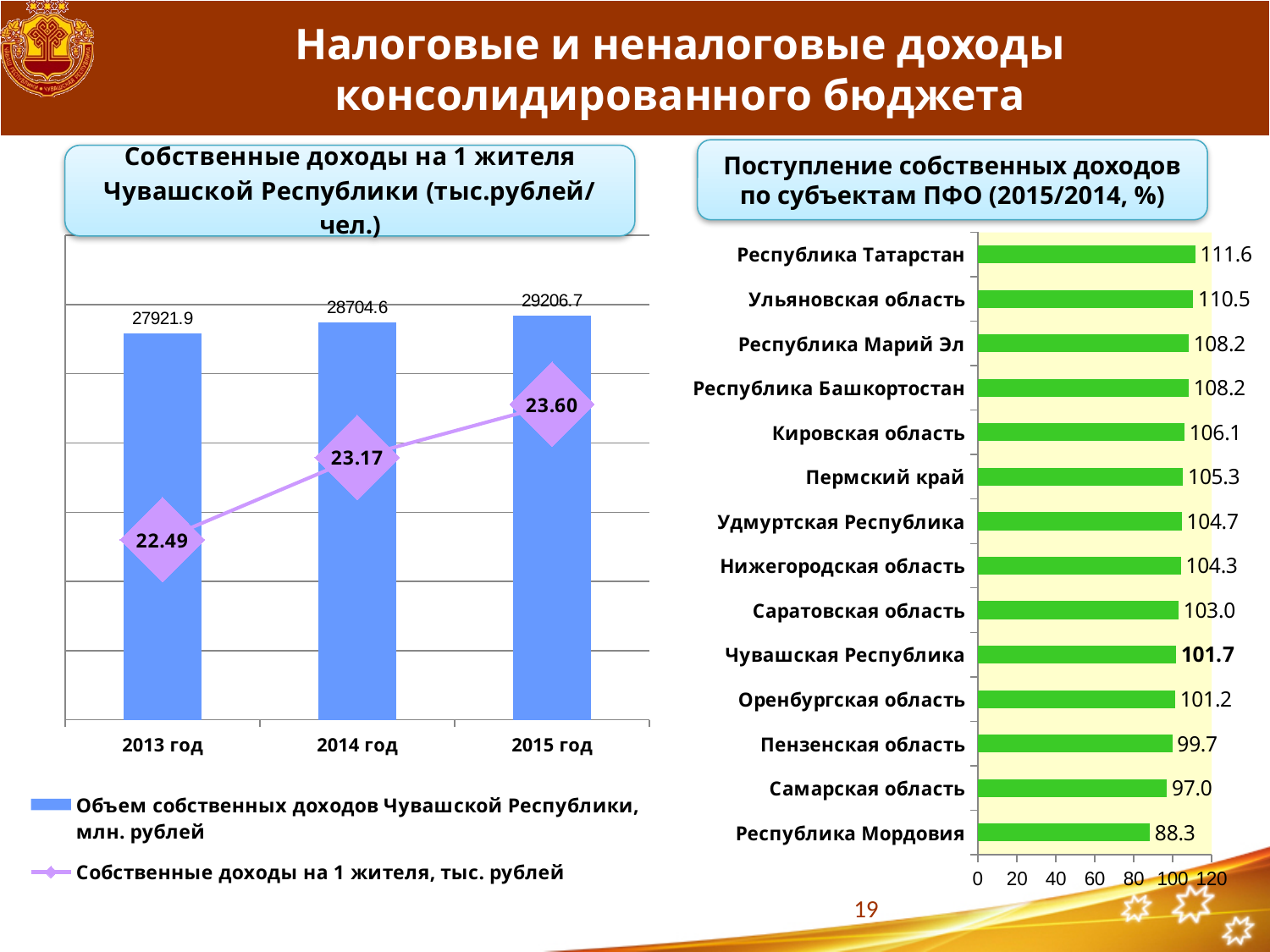
In the right chart, which region has the highest value? Республика Татарстан In the left chart, what is the difference between the bar values for 2015 год and 2013 год? 1284.8 In the left chart, do the bar values rise or fall from 2013 год to 2015 год? rise In the left chart (Собственные доходы на 1 жителя Чувашской Республики), what is the value of the bar for 2014 год? 28704.6 In the right chart, how many regions are shown? 14 In the right chart (Поступление собственных доходов по субъектам ПФО), what is the value for Чувашская Республика? 101.7 How many series does the legend of the left chart list? 2 In the right chart, what is the difference between the values for Ульяновская область and Самарская область? 13.5 In the left chart, what is the value of the line series (Собственные доходы на 1 жителя, тыс. рублей) for 2013 год? 22.49 In the left chart, what is the value of the line series for 2015 год? 23.60 What type of chart is the right chart? bar chart In the right chart, which region has the lowest value? Республика Мордовия